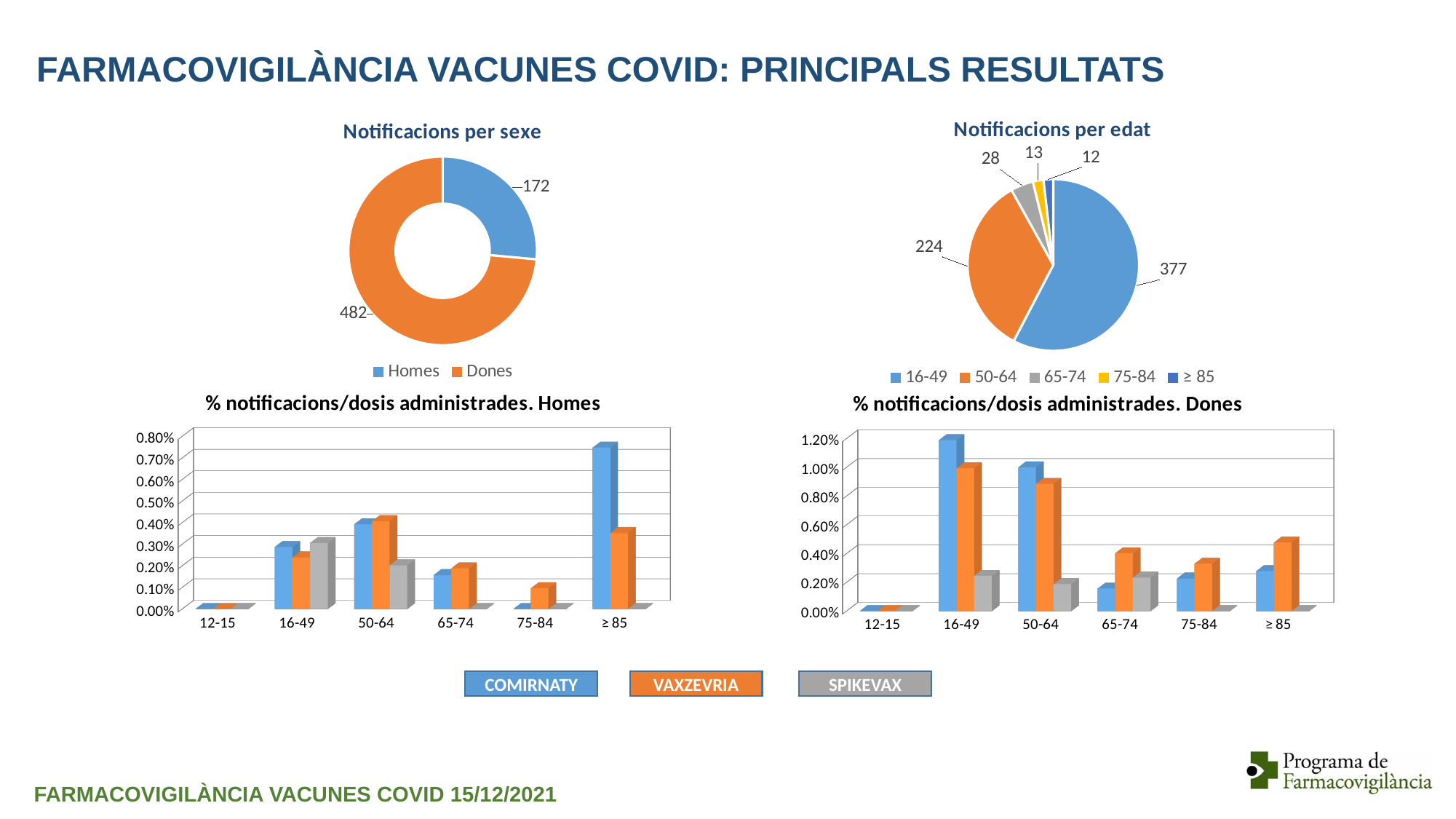
In the '% notificacions/dosis administrades. Dones' chart, is the COMIRNATY value for 16-49 greater or less than 1.00%? greater In the 'Notificacions per edat' chart, what is the total of all the slices? 654 In the 'Notificacions per sexe' chart, what is the difference between Dones and Homes? 310 In the 'Notificacions per sexe' chart, how many notifications are for Homes? 172 What kind of chart is '% notificacions/dosis administrades. Homes'? Bar chart In the '% notificacions/dosis administrades. Homes' chart, is the COMIRNATY value for ≥ 85 greater or less than 0.70%? greater In the 'Notificacions per edat' chart, how many age groups are shown? 5 In the '% notificacions/dosis administrades. Dones' chart, for the 65-74 group, which is larger: COMIRNATY or VAXZEVRIA? VAXZEVRIA In the 'Notificacions per edat' chart, which age group has the most notifications? 16-49 In the 'Notificacions per sexe' chart, how many notifications are for Dones? 482 How many vaccine series are shown in the legend below the bar charts? 3 In the 'Notificacions per edat' chart, how many notifications are for the 50-64 group? 224